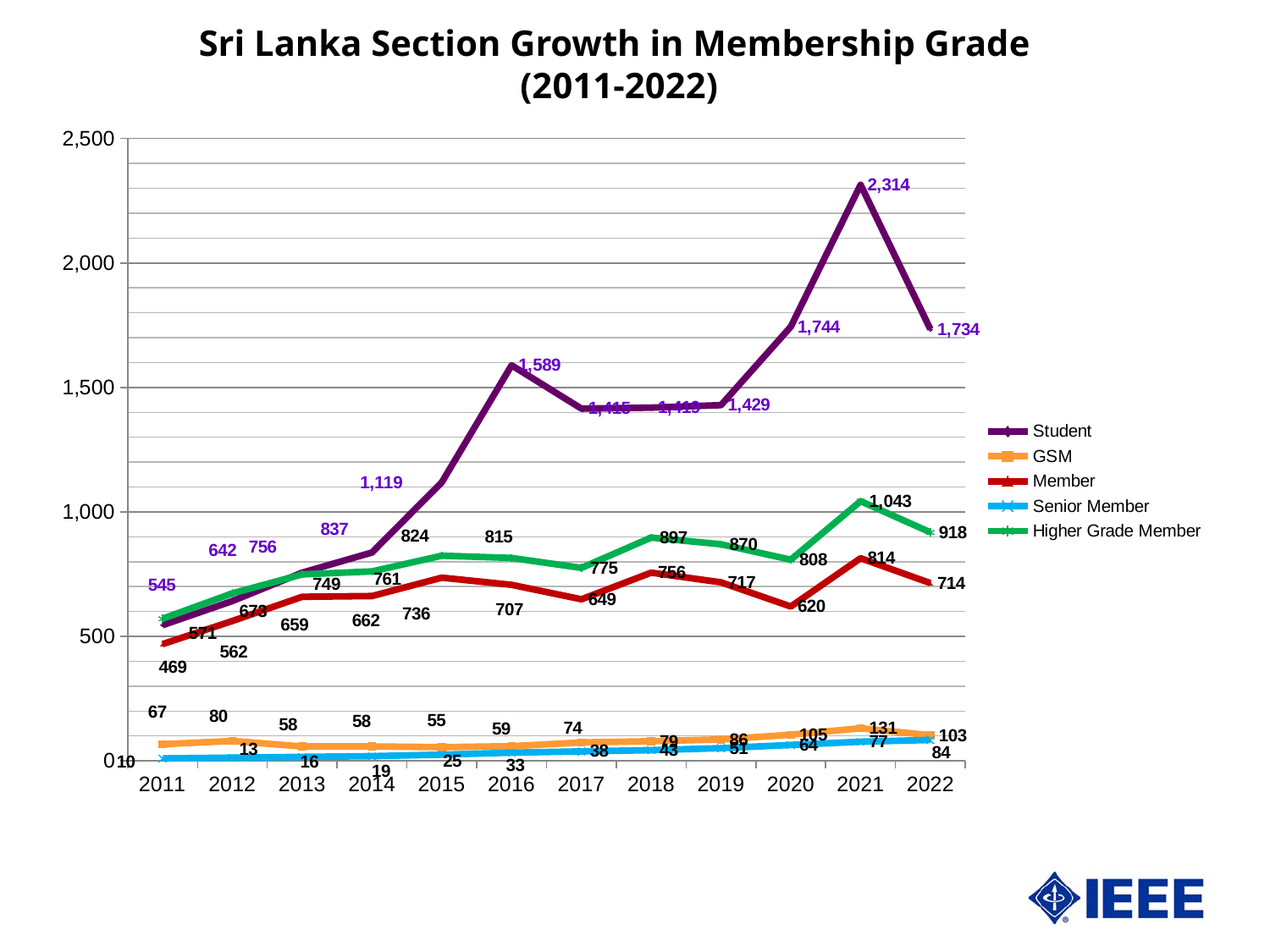
What is the Higher Grade Member value in 2021? 1,043 What is the Senior Member value in 2022? 84 Does the Senior Member series rise or fall from 2011 to 2022? Rise In 2022, which is larger: the Member value or the Higher Grade Member value? Higher Grade Member What is the Member value in 2011? 469 What is the difference between the Student values in 2021 and 2022? 580 How many years are plotted on the x axis? 12 In which year is the GSM value highest? 2021 How many series does the legend list? 5 What kind of chart is shown on the slide? Line chart In which year does the Student series reach its highest value? 2021 What is the Student membership value in 2021? 2,314